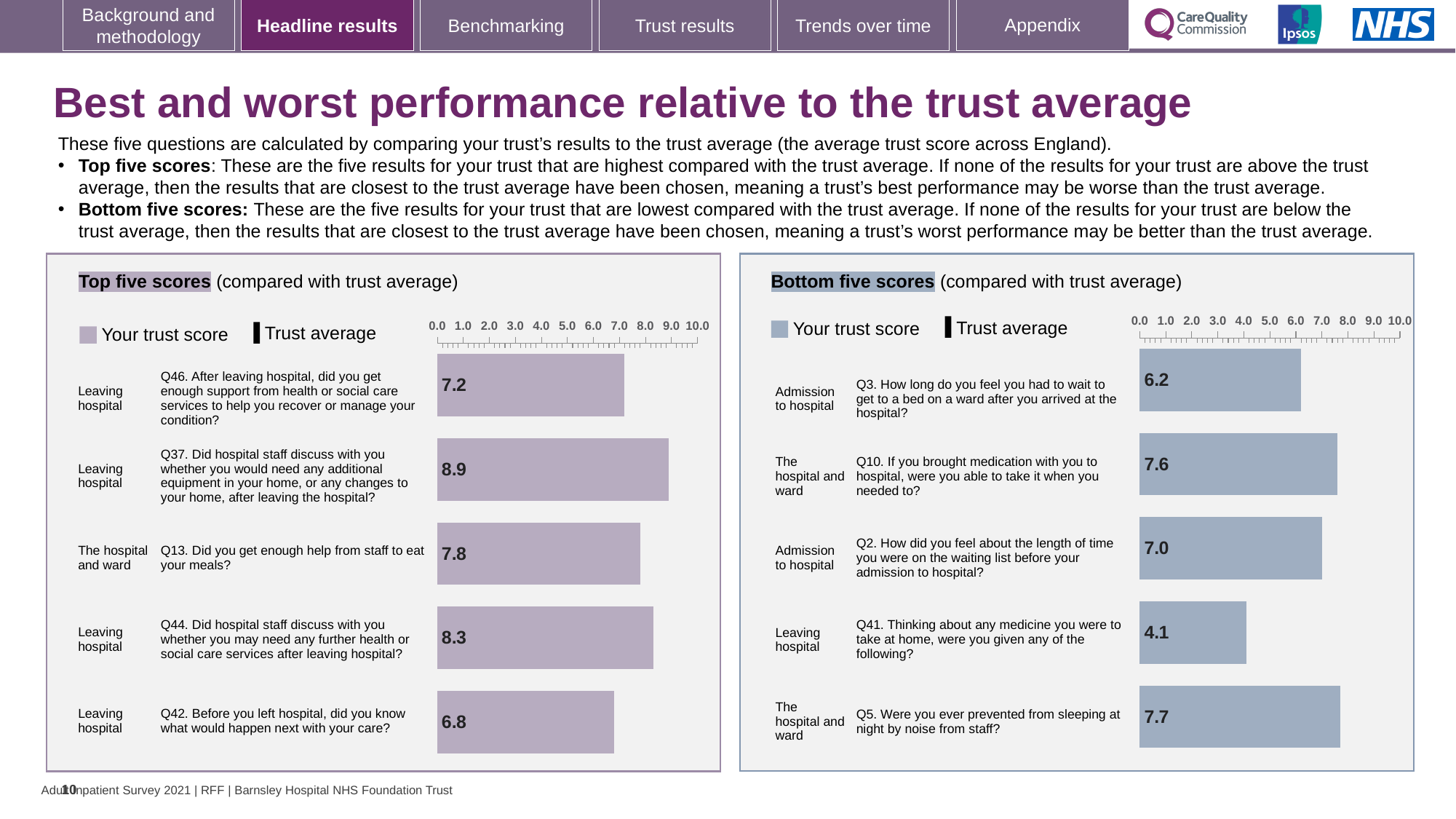
In the Top five scores chart, what is the difference between the scores for Q37 and Q42? 2.1 In the Bottom five scores chart, what is the trust score for Q41 (Thinking about any medicine you were to take at home, were you given any of the following?)? 4.1 In the Top five scores chart, what is the trust score for Q13 (Did you get enough help from staff to eat your meals?)? 7.8 In the Top five scores chart, which question has the highest trust score? Q37 How many questions are shown in the Bottom five scores chart? 5 In the Bottom five scores chart, what is the trust score for Q3 (How long do you feel you had to wait to get to a bed on a ward after you arrived at the hospital?)? 6.2 In the Top five scores chart, what is the trust score for Q42 (Before you left hospital, did you know what would happen next with your care?)? 6.8 How many series does the legend of the Top five scores chart list? 2 In the Bottom five scores chart, what is the difference between the scores for Q10 and Q41? 3.5 In the Bottom five scores chart, which question has the lowest trust score? Q41 What kind of chart is the Bottom five scores chart? Bar chart In the Top five scores chart, which has the larger score, Q46 or Q44? Q44